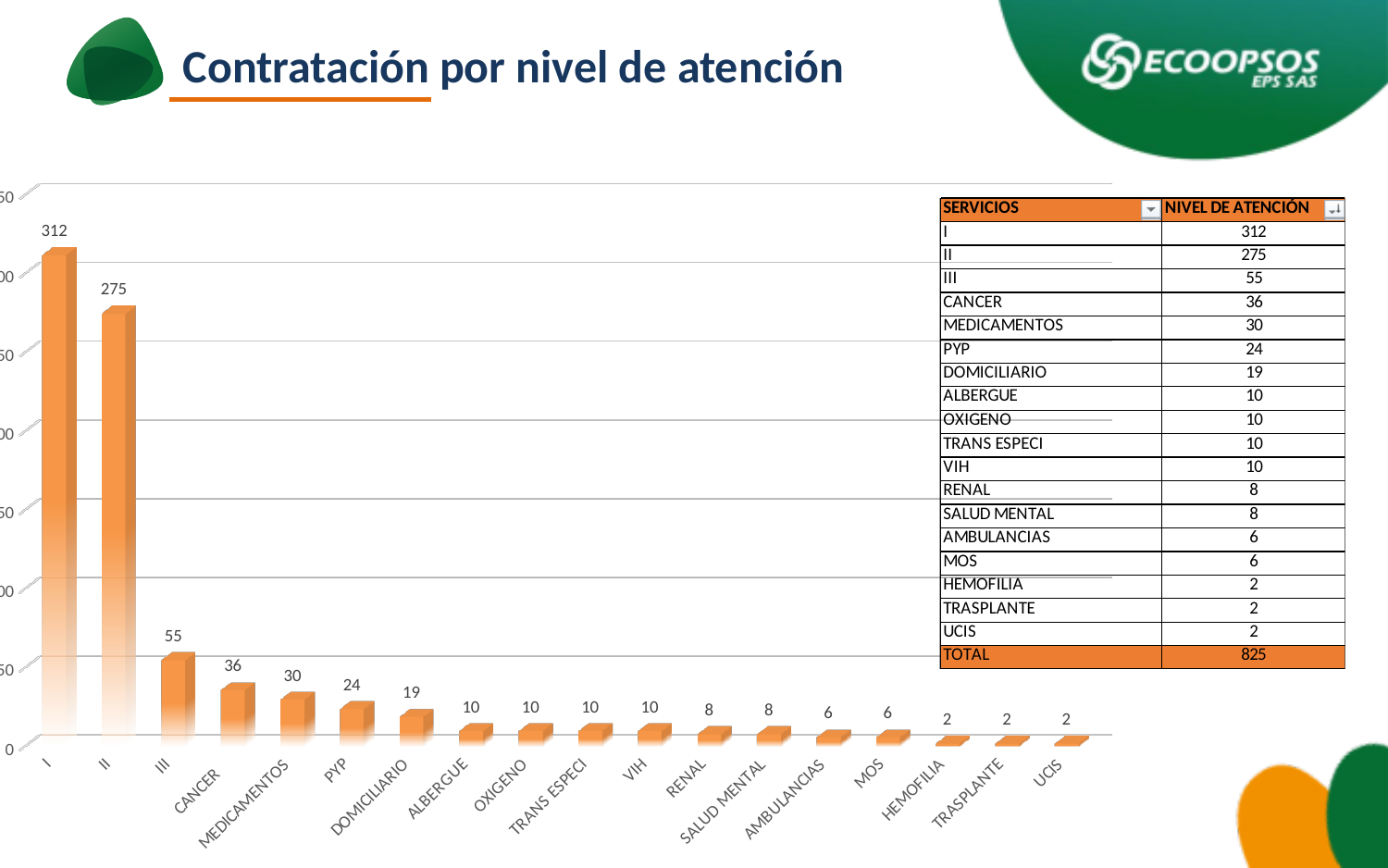
Which is larger, the value for RENAL or the value for AMBULANCIAS? RENAL What is the value for DOMICILIARIO in the chart? 19 Do the values rise or fall from left to right along the x axis? fall Which is larger, the value for PYP or the value for DOMICILIARIO? PYP What kind of chart is shown on the slide? bar chart Which category has the highest value in the chart? I What is the difference between the values for I and II? 37 What is the value for CANCER in the chart? 36 What is the difference between the values for III and CANCER? 19 What is the value of the highest bar in the chart? 312 What is the value for MEDICAMENTOS in the chart? 30 How many categories are shown on the x axis of the chart? 18